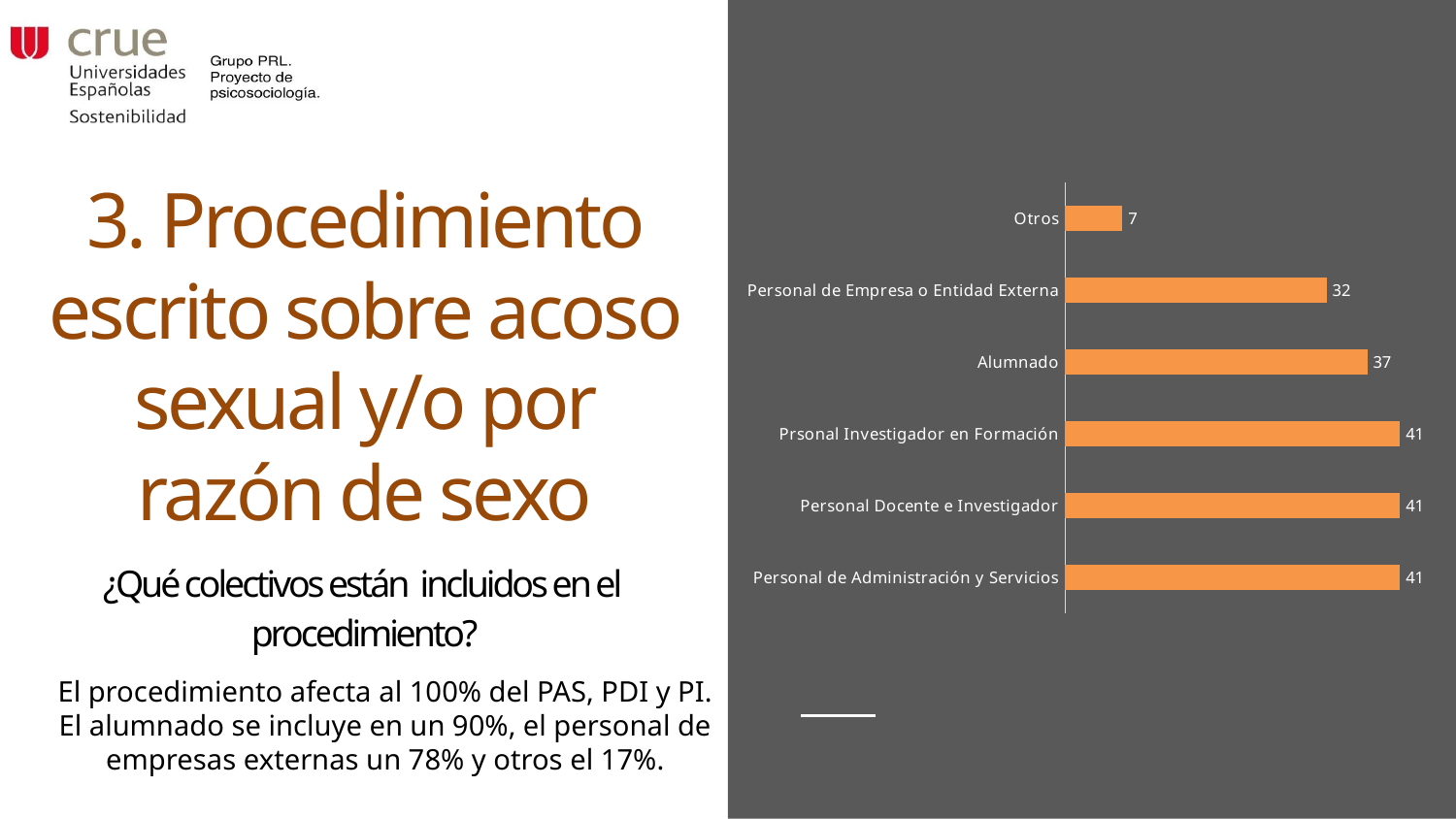
How many categories share the highest value of 41? 3 What value is shown for Otros? 7 What kind of chart is shown on the slide? Bar chart What is the difference between the values for Alumnado and Personal de Empresa o Entidad Externa? 5 How many categories are shown in the chart? 6 What is the difference between the values for Personal de Administración y Servicios and Otros? 34 What value is shown for Personal de Administración y Servicios? 41 What value is shown for Personal Docente e Investigador? 41 What value is shown for Personal de Empresa o Entidad Externa? 32 Which is larger, the value for Alumnado or the value for Personal de Empresa o Entidad Externa? Alumnado Which category has the lowest value? Otros What value is shown for Alumnado? 37